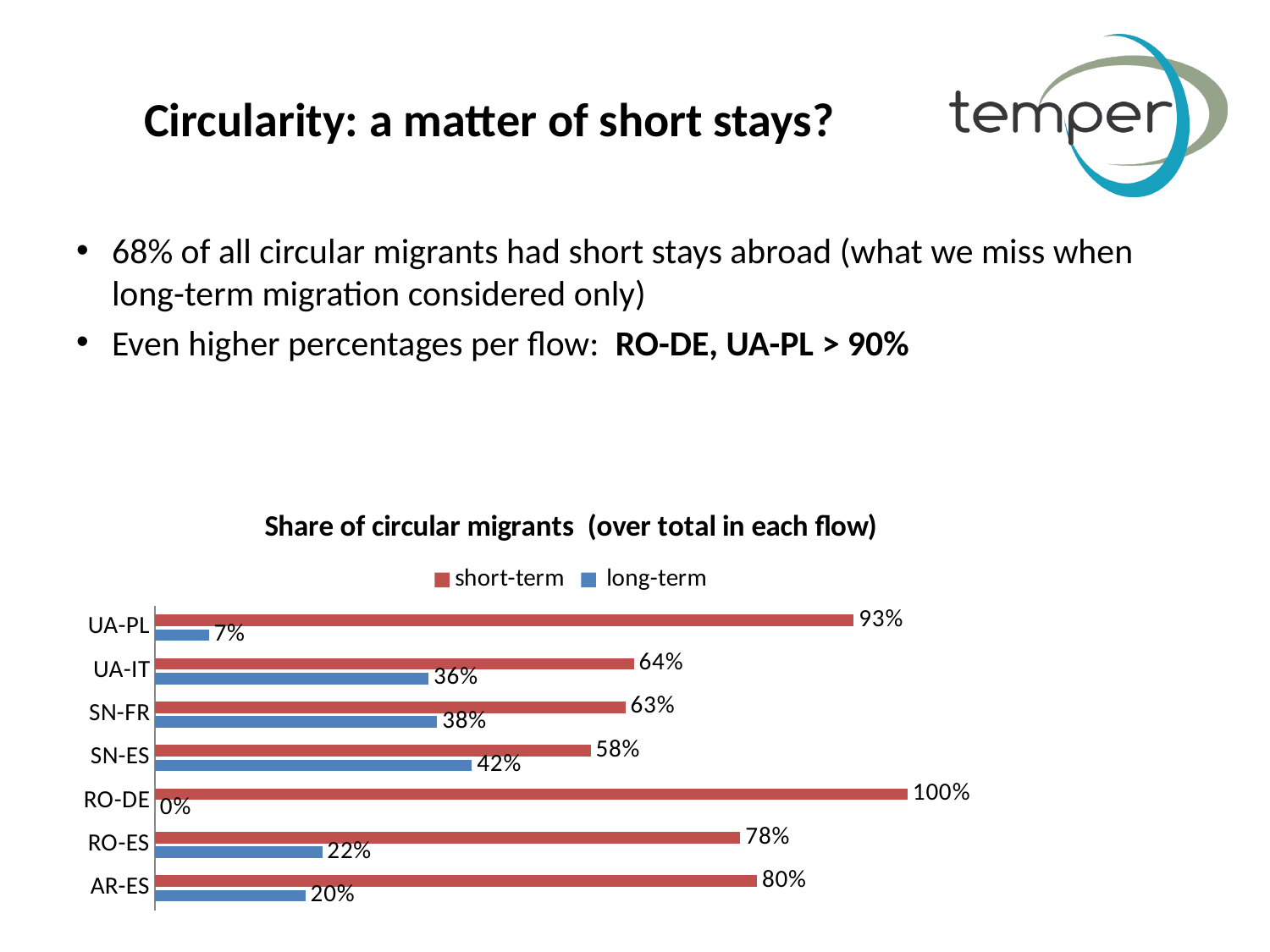
Which colour represents the long-term series? blue What is the short-term value for UA-PL? 93% What is the title of the chart? Share of circular migrants (over total in each flow) What is the difference between the short-term and long-term values for AR-ES? 60% How many categories are shown on the chart? 7 What is the long-term value for SN-ES? 42% Which category has the highest short-term value? RO-DE Which is larger, the short-term value for RO-ES or the short-term value for AR-ES? AR-ES How many series does the legend list? 2 What kind of chart is shown on the slide? bar chart Which category has the lowest long-term value? RO-DE What is the long-term value for RO-DE? 0%